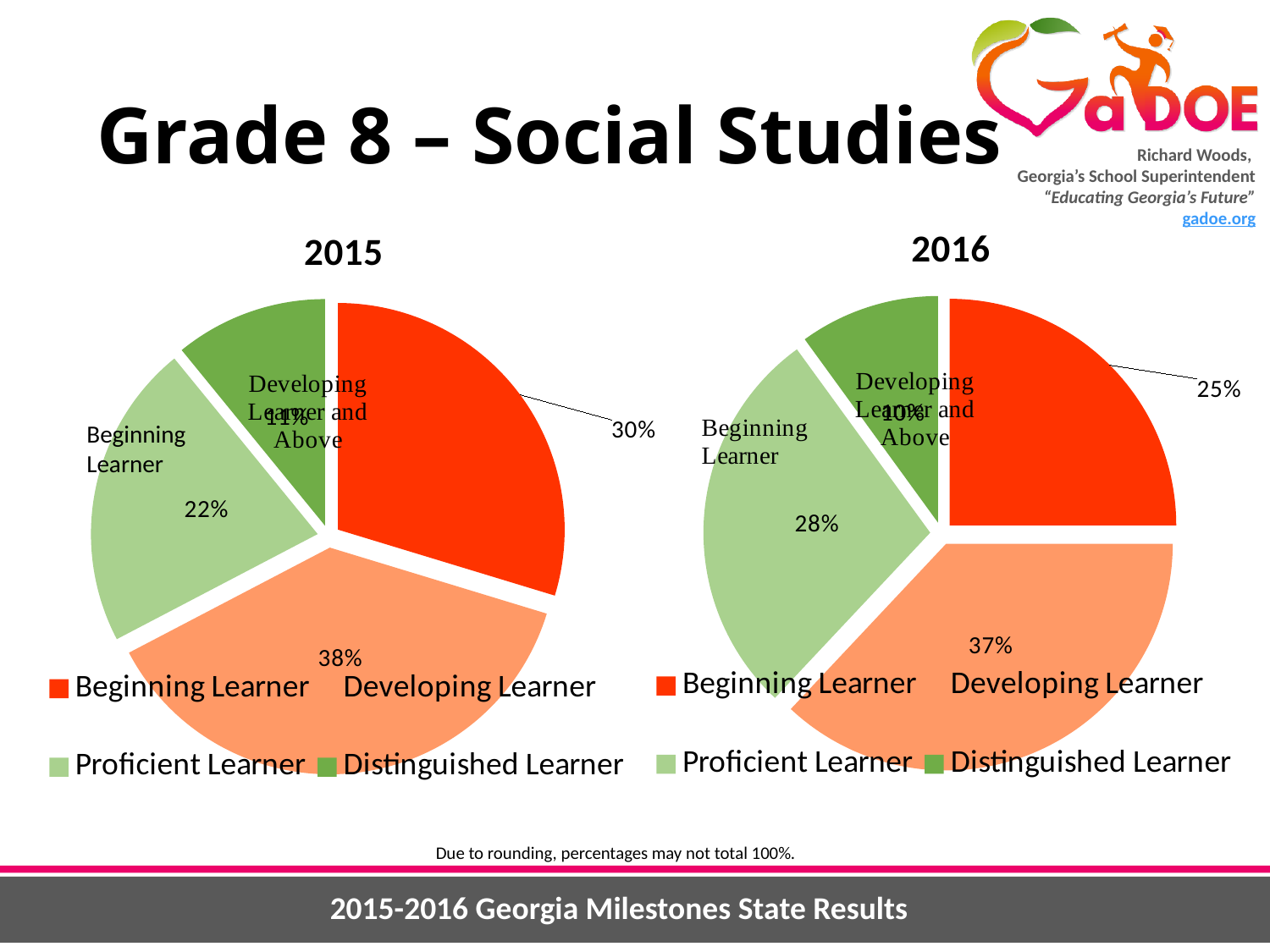
In the 2015 chart, which category has the largest slice? Developing Learner In the 2015 chart, what colour is the Beginning Learner slice? Red In the 2016 chart, which is larger: Developing Learner or Proficient Learner? Developing Learner In the 2016 chart, what percentage is shown for Proficient Learner? 28% In the 2015 chart, what percentage is shown for Proficient Learner? 22% In the 2016 chart, which category has the smallest slice? Distinguished Learner How many entries does the legend of the 2015 chart list? 4 What type of chart is used for the 2016 data? Pie chart In the 2015 chart, what percentage is shown for Developing Learner? 38% In the 2016 chart, what percentage is shown for Beginning Learner? 25% What is the difference between the Beginning Learner percentages in the 2015 and 2016 charts? 5% How many slices does the 2015 pie chart have? 4